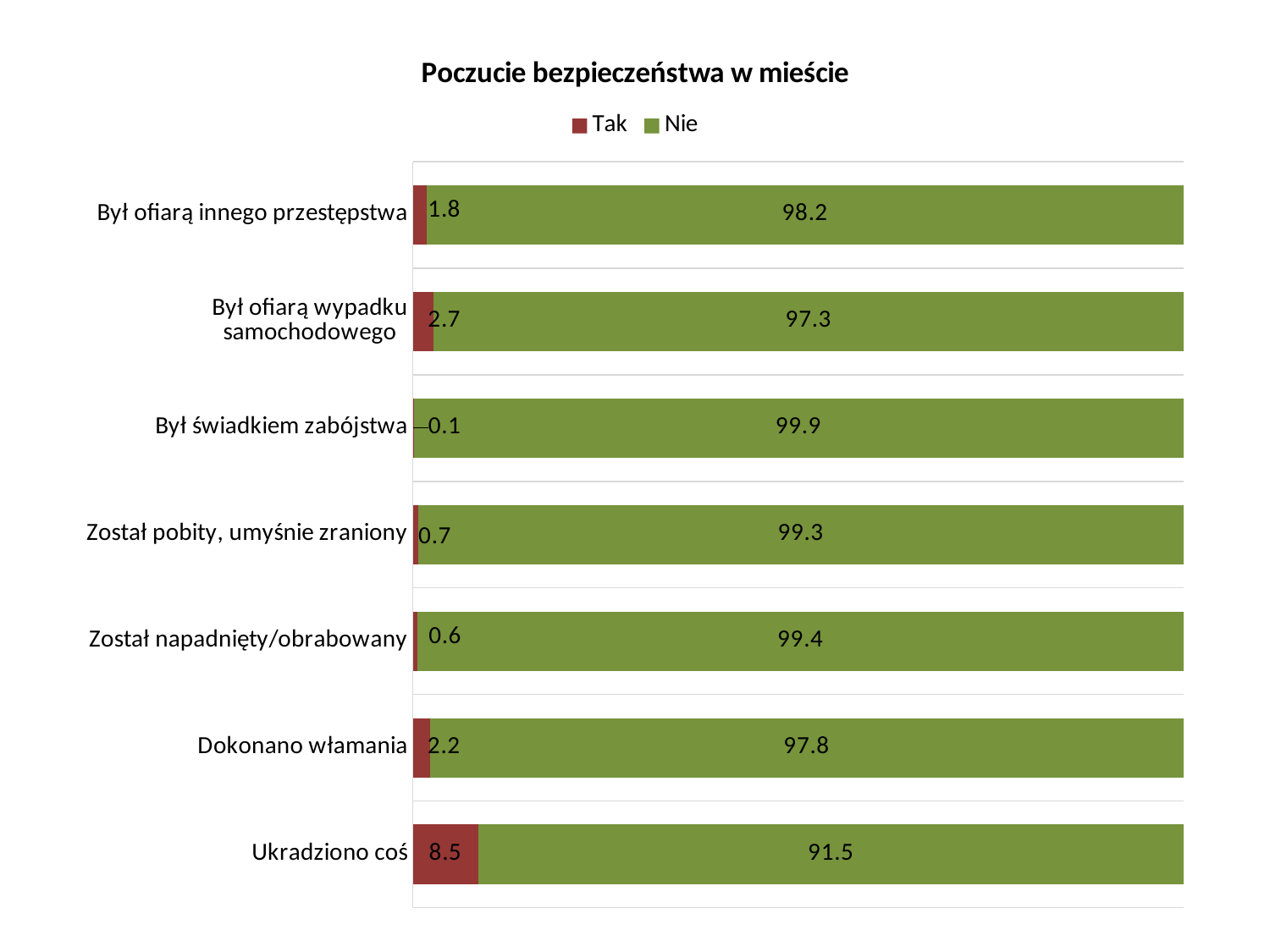
Which category has the lowest 'Tak' value? Był świadkiem zabójstwa What is the difference between the 'Tak' values for 'Ukradziono coś' and 'Dokonano włamania'? 6.3 Which category has the highest 'Tak' value? Ukradziono coś What is the 'Nie' value for 'Był ofiarą wypadku samochodowego'? 97.3 What is the 'Nie' value for 'Był świadkiem zabójstwa'? 99.9 How many series does the legend list? 2 What is the 'Tak' value for 'Ukradziono coś'? 8.5 Which has a larger 'Tak' value: 'Był ofiarą innego przestępstwa' or 'Był ofiarą wypadku samochodowego'? Był ofiarą wypadku samochodowego What is the 'Tak' value for 'Dokonano włamania'? 2.2 What kind of chart is this? Stacked bar chart What is the title of the chart? Poczucie bezpieczeństwa w mieście How many categories are shown in the chart? 7